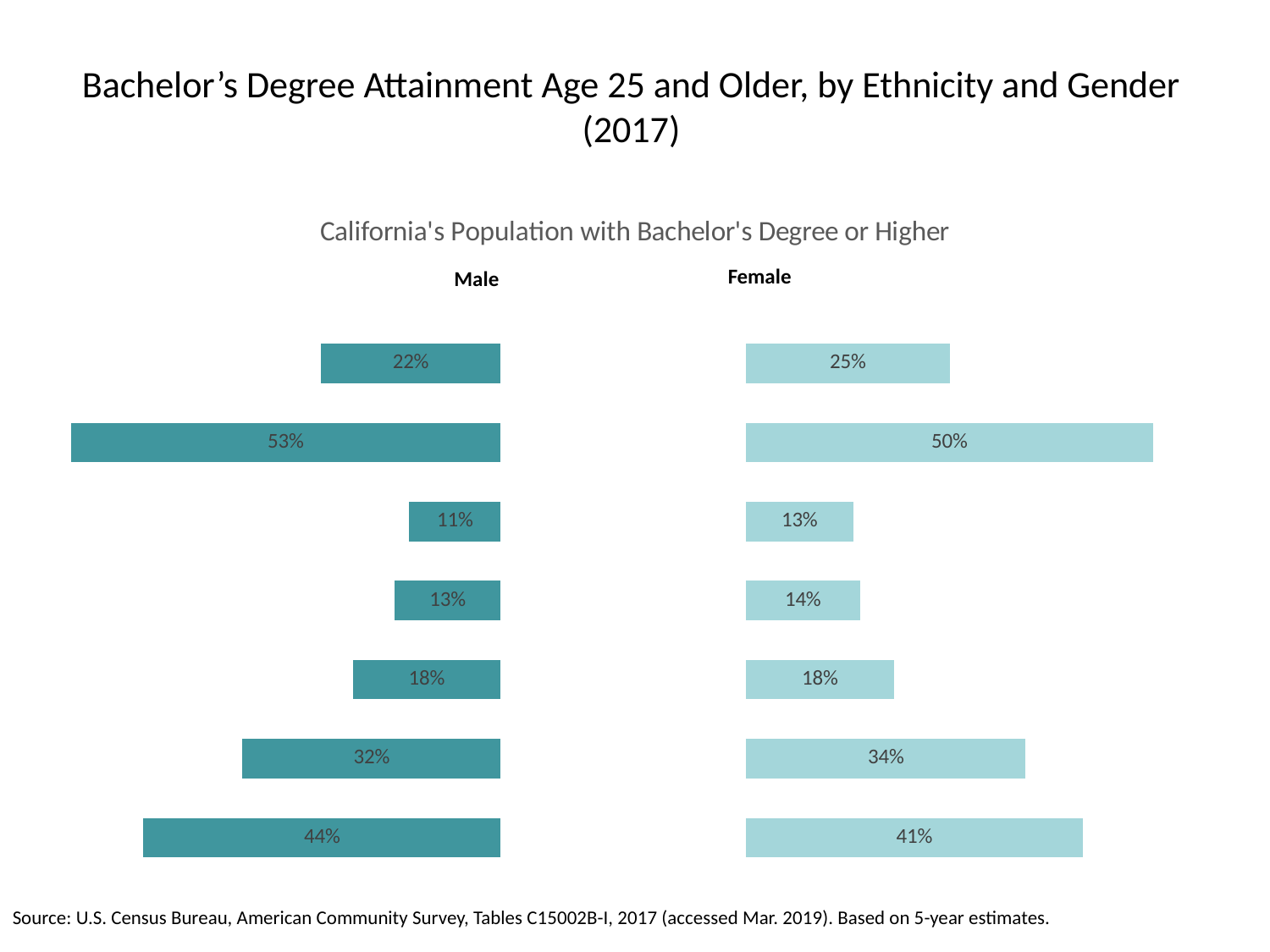
How many bars are shown in the Male series? 7 What kind of chart is shown on the slide? Bar chart What is the Female value for the bottom bar of the chart? 41% For the bottom bar of the chart, which is larger, the Male value or the Female value? Male What is the lowest value in the Male series? 11% What is the highest value in the Female series? 50% What is the lowest value in the Female series? 13% What is the highest value in the Male series? 53% How many series does the chart show? 2 For the second bar from the top, what is the difference between the Male and Female values? 3 percentage points What is the Male value for the bottom bar of the chart? 44% What is the title of the chart? California's Population with Bachelor's Degree or Higher